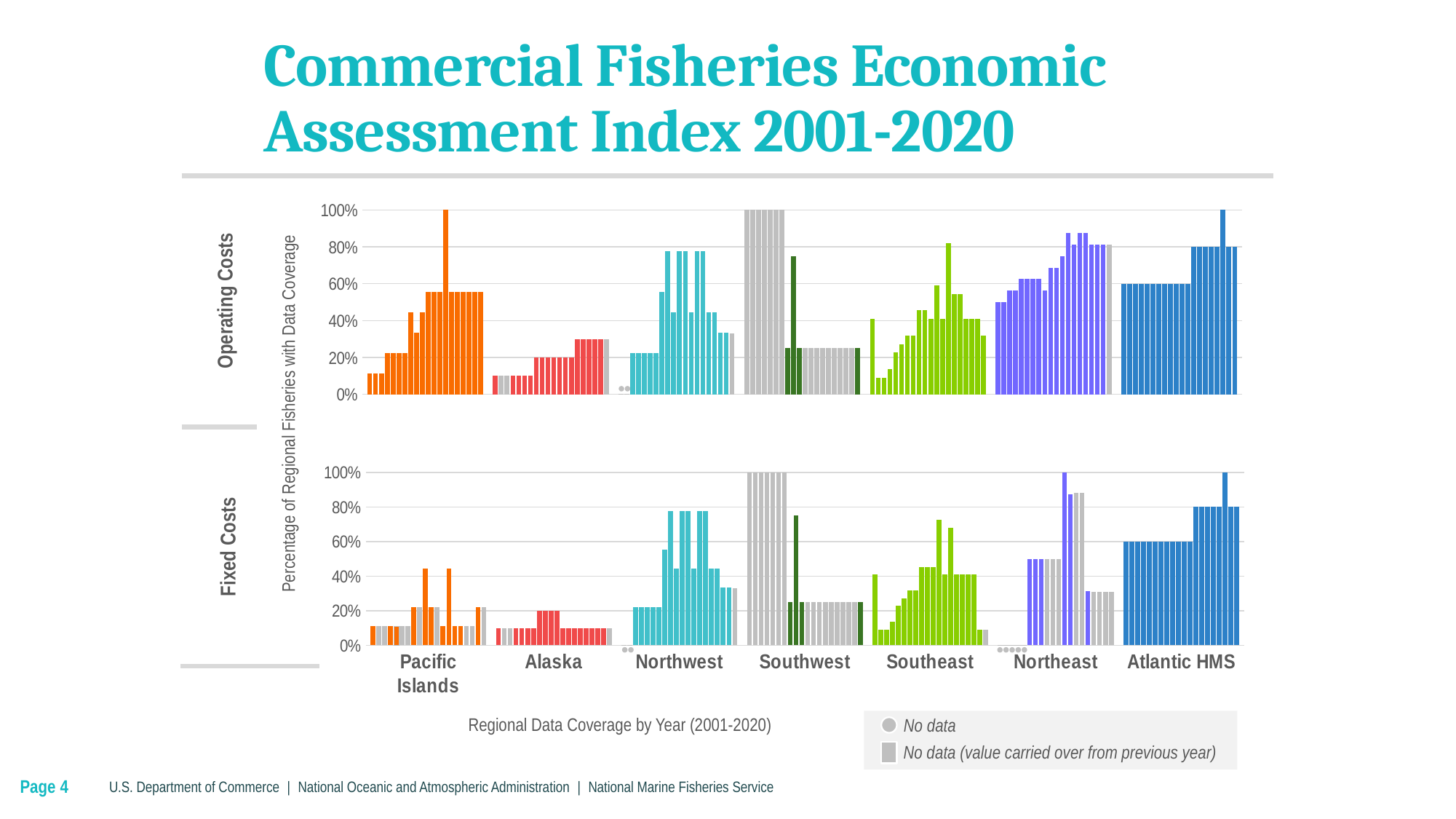
In the Operating Costs chart, which region has larger values, Alaska or Atlantic HMS? Atlantic HMS What is the label on the shared y axis of the two charts? Percentage of Regional Fisheries with Data Coverage How many regions are shown along the x axis of the charts? 7 What kind of chart is used on this slide for Operating Costs and Fixed Costs? Bar chart In the Operating Costs chart, do the values for Pacific Islands rise or fall across the years? rise What are the two entries in the legend below the charts? No data; No data (value carried over from previous year) In the Operating Costs chart, what is the highest value reached by the Southwest region? 100% In the Operating Costs chart, are the values for Alaska greater or less than 40%? less In the Fixed Costs chart, do the values for Atlantic HMS rise or fall across the years? rise In the Fixed Costs chart, are the values for Atlantic HMS greater or less than 40%? greater In the Operating Costs chart, are the values for Northeast greater or less than 40%? greater